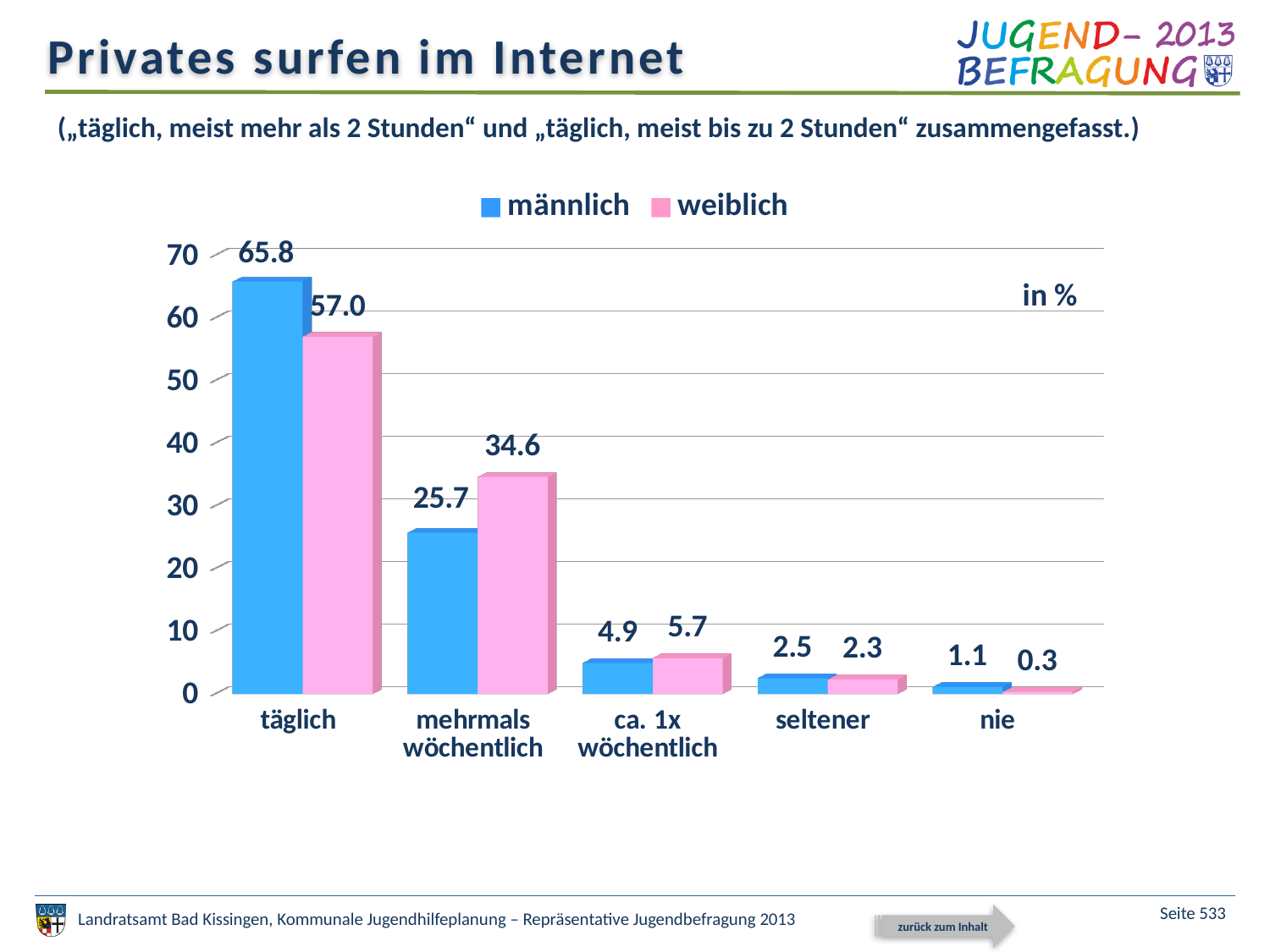
What is the value for weiblich in the nie category? 0.3 What kind of chart is shown on the slide? bar chart Which is larger in the ca. 1x wöchentlich category, männlich or weiblich? weiblich Which category has the highest value for weiblich? täglich What is the difference between weiblich and männlich in the mehrmals wöchentlich category? 8.9 What is the value for weiblich in the mehrmals wöchentlich category? 34.6 How many series does the legend list? 2 Which category has the lowest value for männlich? nie Do the values for männlich rise or fall from täglich to nie along the x axis? fall How many categories are shown on the x axis? 5 What is the value for männlich in the täglich category? 65.8 What is the difference between männlich and weiblich in the täglich category? 8.8